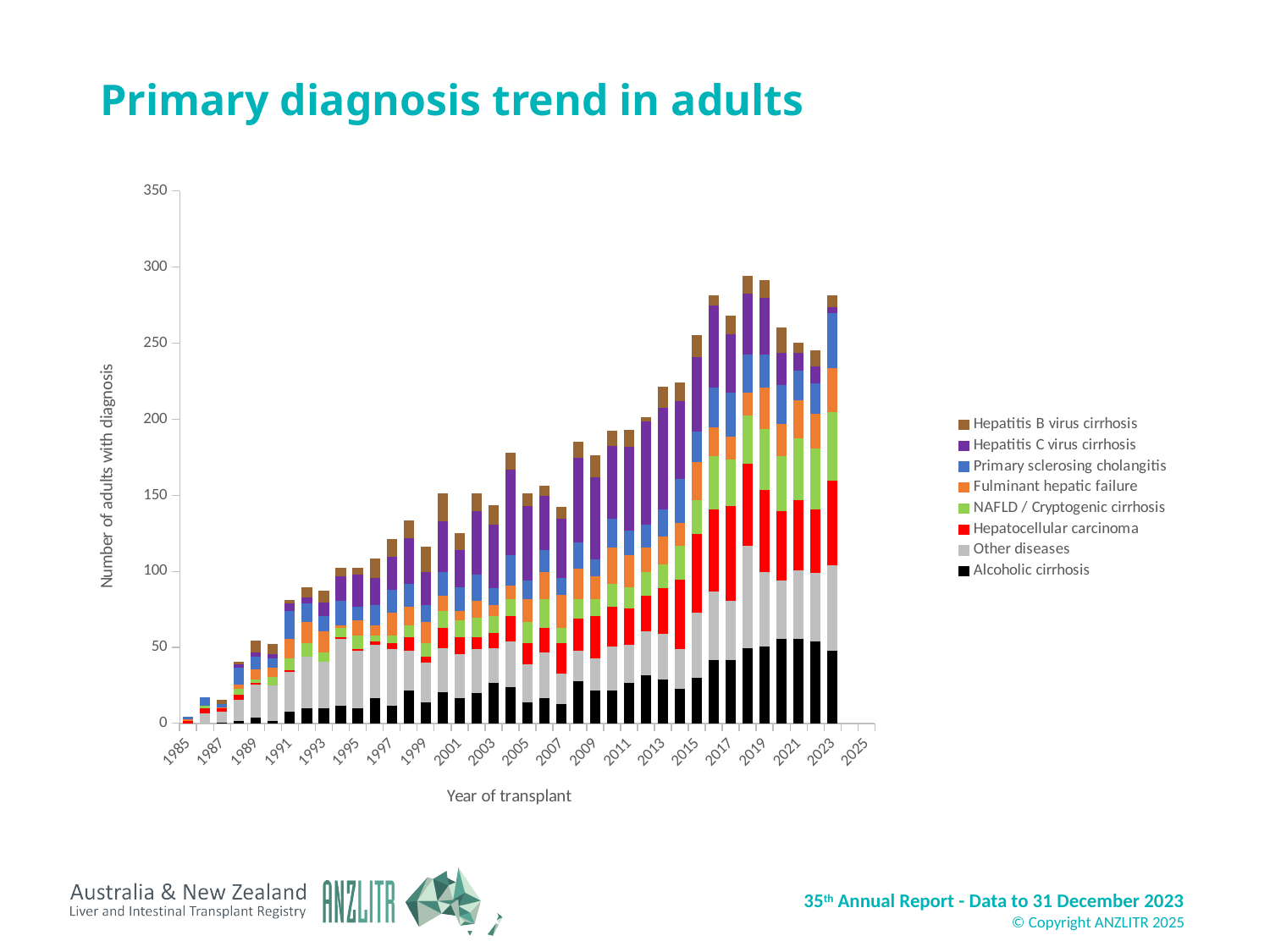
What is the label of the vertical axis? Number of adults with diagnosis Which year has the larger total number of adults, 2023 or 2021? 2023 Is the total number of adults for 2001 greater or less than 150? less What kind of chart is shown on the slide? Stacked bar chart Is the total number of adults for 1991 greater or less than 50? greater Is the total number of adults for 2023 greater or less than 250? greater Overall, do the total numbers of adults with a diagnosis rise or fall from 1985 to 2018? rise What is the title of the chart? Primary diagnosis trend in adults Which year has the lowest total number of adults with a diagnosis? 1985 How many series does the legend list? 8